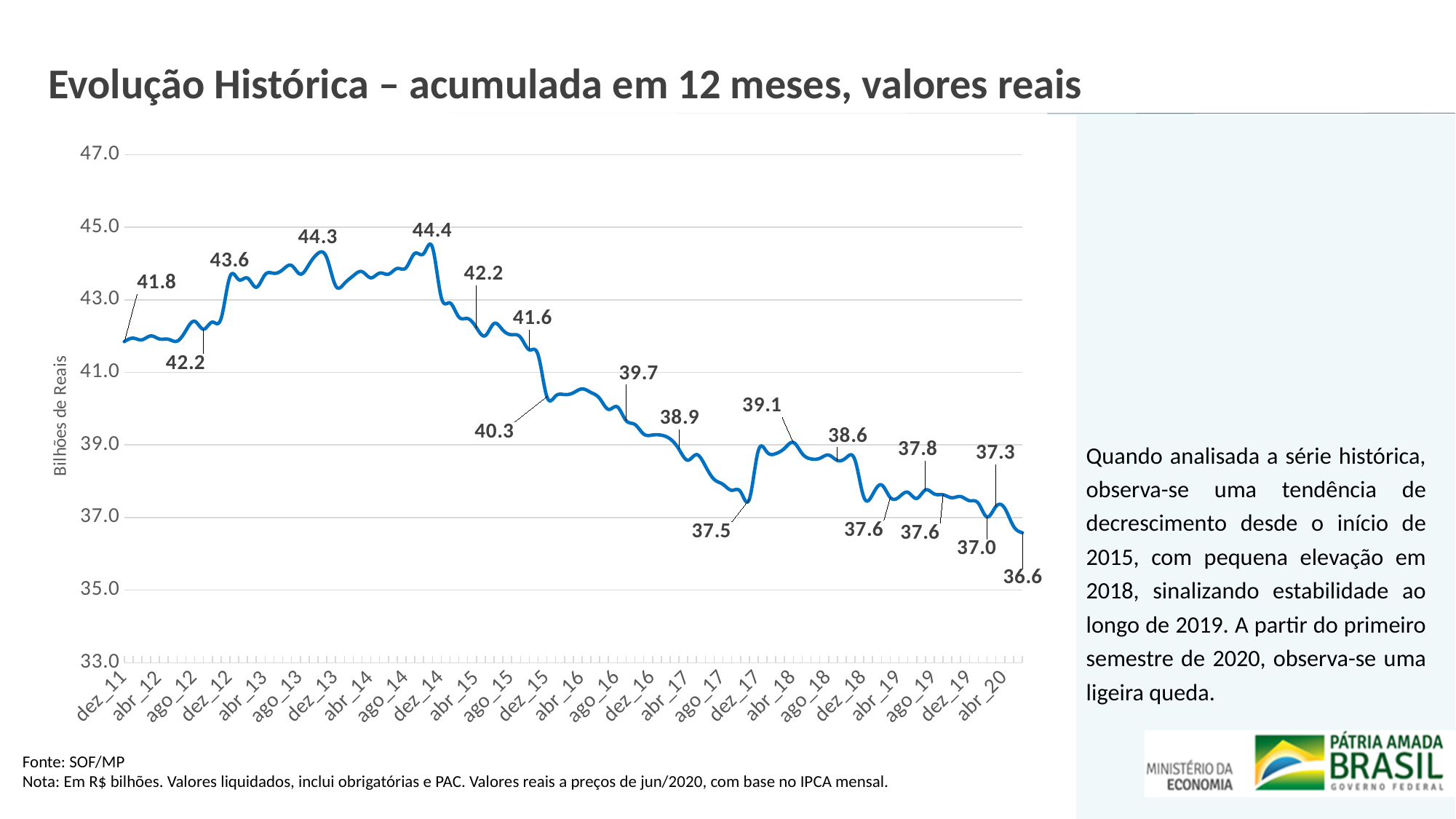
What is the difference between the highest labelled value (44.4) and the lowest labelled value (36.6)? 7.8 What kind of chart is shown on the slide? line chart What is the difference between the first labelled value (41.8) and the last labelled value (36.6)? 5.2 What is the label on the vertical axis of the chart? Bilhões de Reais What is the title of the chart? Evolução Histórica – acumulada em 12 meses, valores reais What is the value labelled at the last point of the series? 36.6 Overall, do the values rise or fall from dez_11 to the end of the series? fall What is the lowest value labelled on the chart? 36.6 Which is larger, the value at the first point of the series (dez_11) or the value at the last point? the first point (dez_11) What is the value labelled at the first point of the series (dez_11)? 41.8 Is the value at the first point of the series (dez_11) greater or less than 41.0? greater What is the highest value labelled on the chart? 44.4